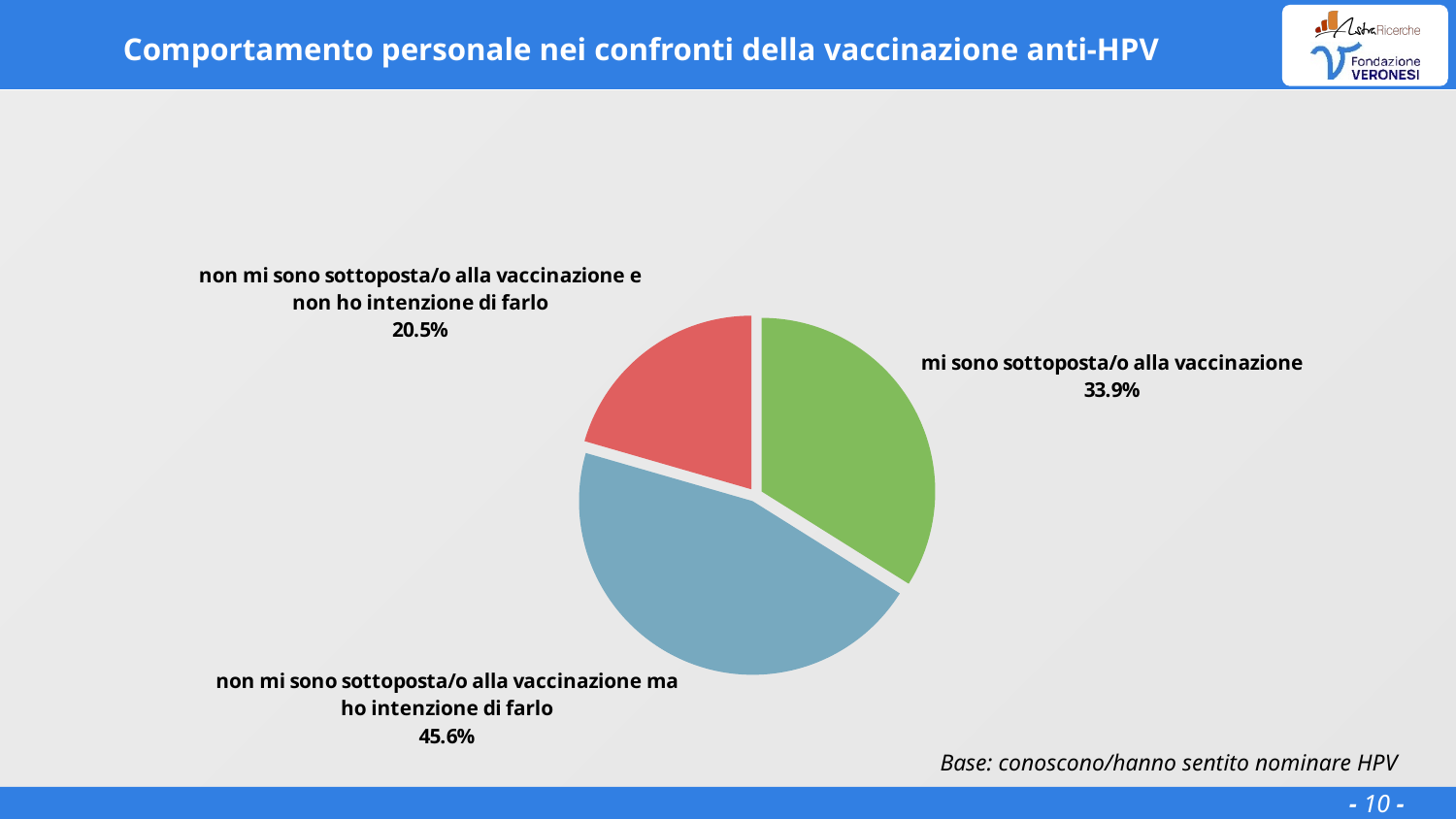
What percentage of respondents answered "mi sono sottoposta/o alla vaccinazione"? 33.9% How many slices does the pie chart have? 3 What colour is the slice for "mi sono sottoposta/o alla vaccinazione"? Green What is the title of the slide? Comportamento personale nei confronti della vaccinazione anti-HPV Which is larger: the share for "mi sono sottoposta/o alla vaccinazione" or the share for "non mi sono sottoposta/o alla vaccinazione e non ho intenzione di farlo"? mi sono sottoposta/o alla vaccinazione Which response has the largest share of the pie? non mi sono sottoposta/o alla vaccinazione ma ho intenzione di farlo Which response has the smallest share of the pie? non mi sono sottoposta/o alla vaccinazione e non ho intenzione di farlo What percentage of respondents answered "non mi sono sottoposta/o alla vaccinazione e non ho intenzione di farlo"? 20.5% What is the difference in percentage points between "mi sono sottoposta/o alla vaccinazione" and "non mi sono sottoposta/o alla vaccinazione e non ho intenzione di farlo"? 13.4 What kind of chart is shown on the slide? Pie chart What is the difference in percentage points between "non mi sono sottoposta/o alla vaccinazione ma ho intenzione di farlo" and "mi sono sottoposta/o alla vaccinazione"? 11.7 What percentage of respondents answered "non mi sono sottoposta/o alla vaccinazione ma ho intenzione di farlo"? 45.6%